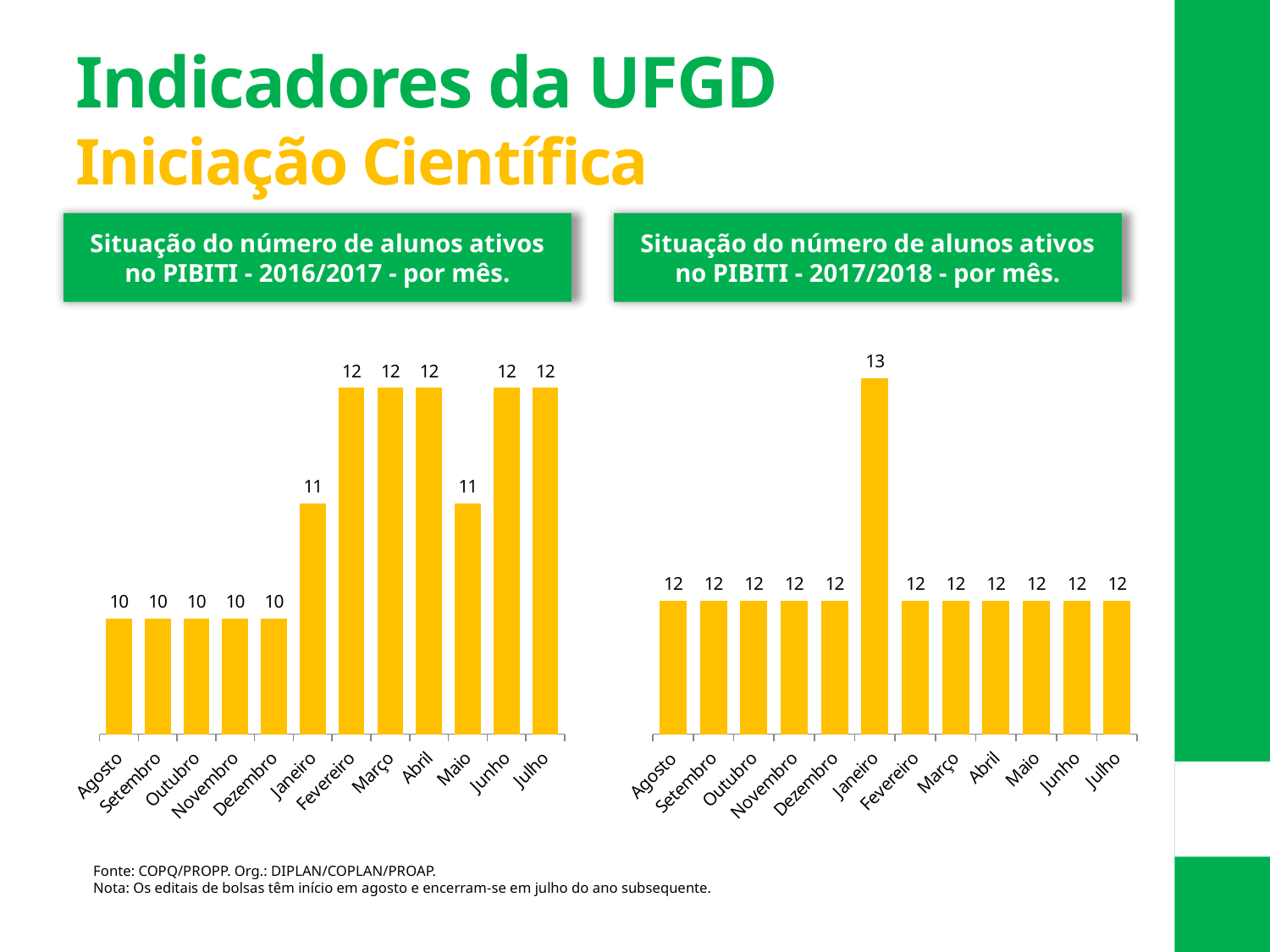
In the 2016/2017 chart, which is larger, the value for Janeiro or the value for Dezembro? Janeiro How many months are shown in the 2017/2018 chart? 12 In the 2016/2017 chart, what is the difference between the values for Fevereiro and Agosto? 2 In the 2017/2018 chart, what is the value for Janeiro? 13 In the 2017/2018 chart, what is the difference between the values for Janeiro and Fevereiro? 1 In the 2017/2018 chart, which month has the highest value? Janeiro In the 2017/2018 chart, what is the value for Julho? 12 In the 2016/2017 chart, what is the value for Agosto? 10 In the 2016/2017 chart, what is the value for Maio? 11 In the 2016/2017 chart, do the values generally rise or fall from Agosto to Julho? Rise What kind of chart is the 2016/2017 chart? Bar chart What is the title of the chart on the left? Situação do número de alunos ativos no PIBITI - 2016/2017 - por mês.